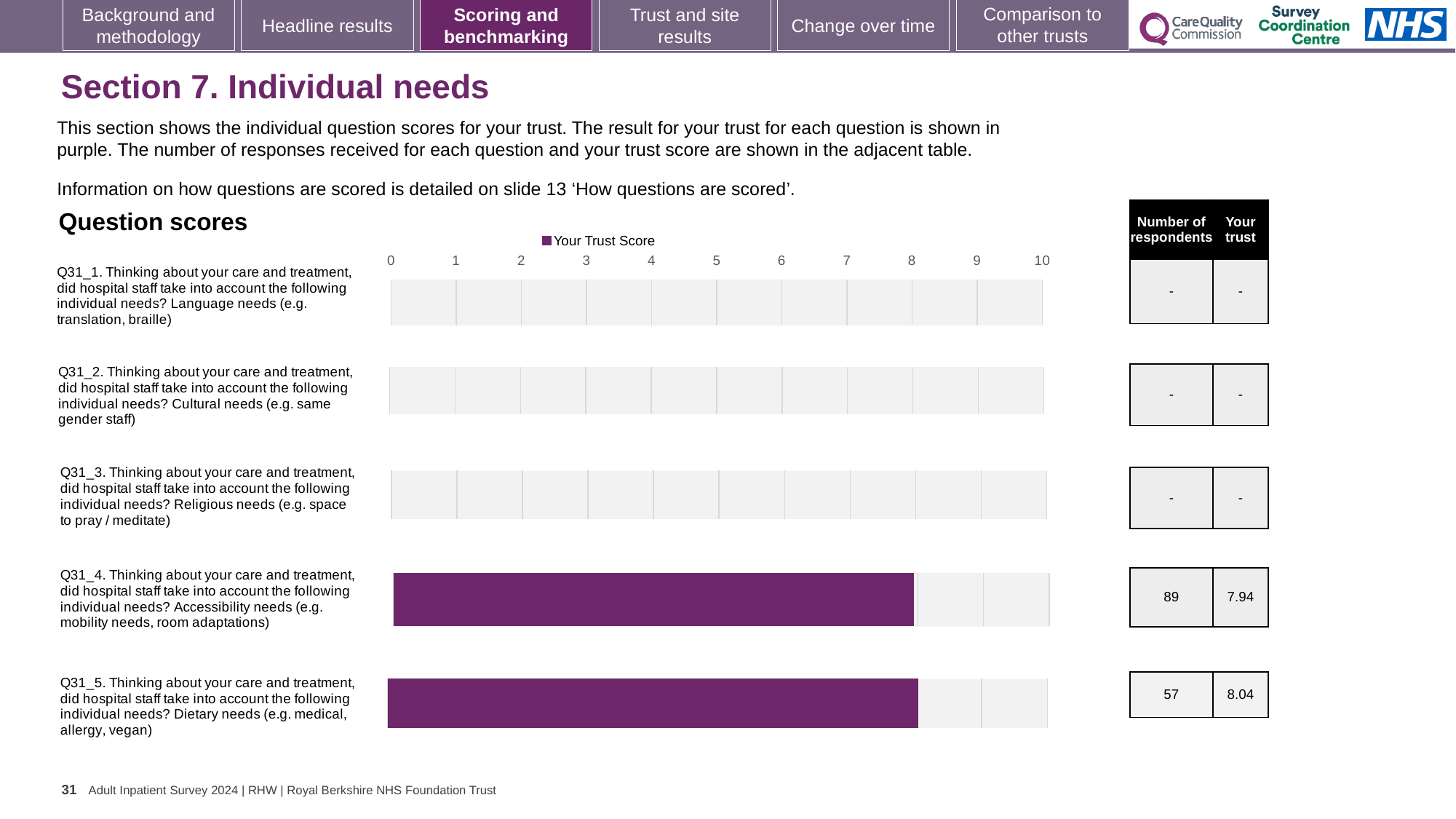
Is the trust score for Q31_4 greater or less than 5? greater Is the trust score for Q31_5 greater or less than 9? less How many respondents answered Q31_4 (Accessibility needs)? 89 How many questions are listed in the Question scores chart? 5 What is the trust score for Q31_5 (Dietary needs)? 8.04 How many series does the chart legend list? 1 What is the difference between the trust scores for Q31_5 and Q31_4? 0.1 Which question has the higher trust score, Q31_4 or Q31_5? Q31_5 How many respondents answered Q31_5 (Dietary needs)? 57 What is the trust score for Q31_4 (Accessibility needs)? 7.94 What type of chart is used to show the question scores? Bar chart How many more respondents answered Q31_4 than Q31_5? 32